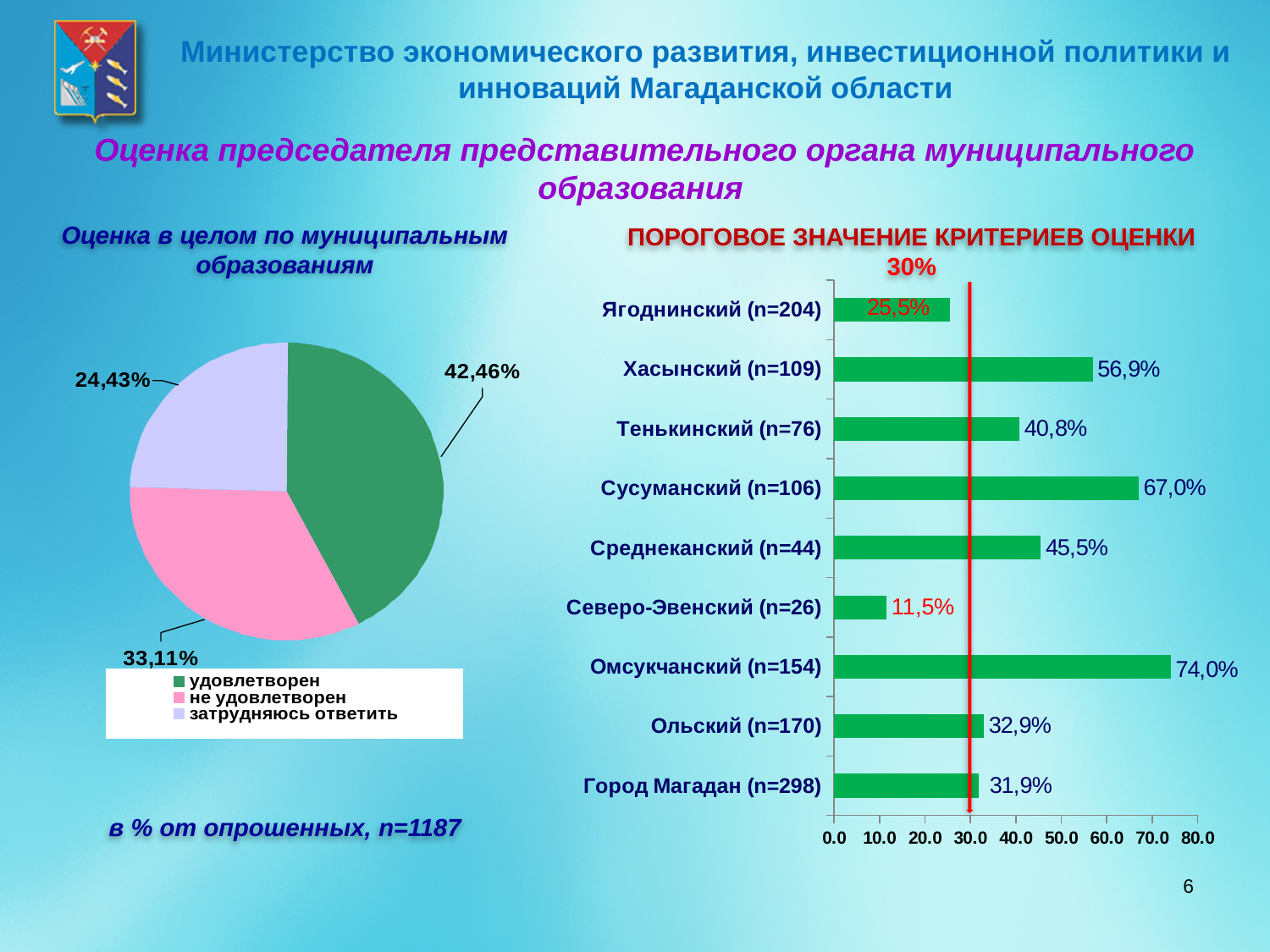
In the pie chart on the left, what share of respondents answered "удовлетворен"? 42,46% In the pie chart on the left, which answer has the smallest share? затрудняюсь ответить In the pie chart on the left, what is the difference between the "удовлетворен" and "не удовлетворен" shares? 9,35% In the bar chart on the right, which is larger: the value for Хасынский (n=109) or Тенькинский (n=76)? Хасынский (n=109) How many entries does the legend of the pie chart on the left list? 3 What type of chart is the chart on the right of the slide? bar chart In the bar chart on the right, what is the value for Город Магадан (n=298)? 31,9% In the pie chart on the left, what share of respondents answered "затрудняюсь ответить"? 24,43% How many municipalities are shown in the bar chart on the right? 9 In the bar chart on the right, which municipality has the lowest value? Северо-Эвенский (n=26) In the bar chart on the right, what is the value for Омсукчанский (n=154)? 74,0% In the bar chart on the right, which municipality has the highest value? Омсукчанский (n=154)